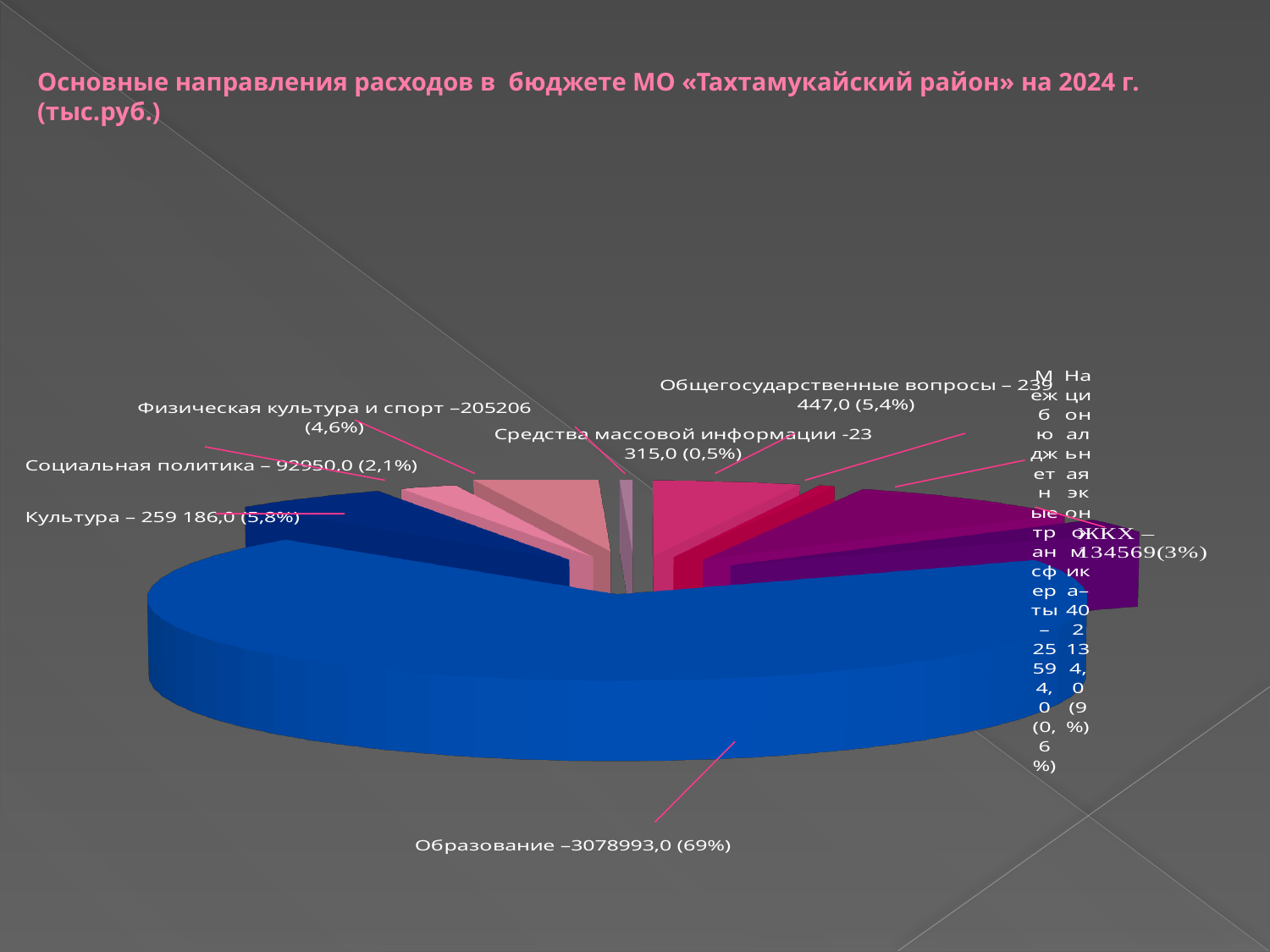
What share of the pie does Образование represent? 69% What is the value for Социальная политика? 92950,0 What is the value for Культура? 259 186,0 What is the value for Образование? 3078993,0 Which category has the largest slice of the pie? Образование What is the value for Общегосударственные вопросы? 239 447,0 What is the value for Физическая культура и спорт? 205206 What share of the pie does Культура represent? 5,8% Which is larger, the value for Культура or the value for Общегосударственные вопросы? Культура What share of the pie does Средства массовой информации represent? 0,5% What is the value for ЖКХ? 134569 What kind of chart is shown on the slide? pie chart